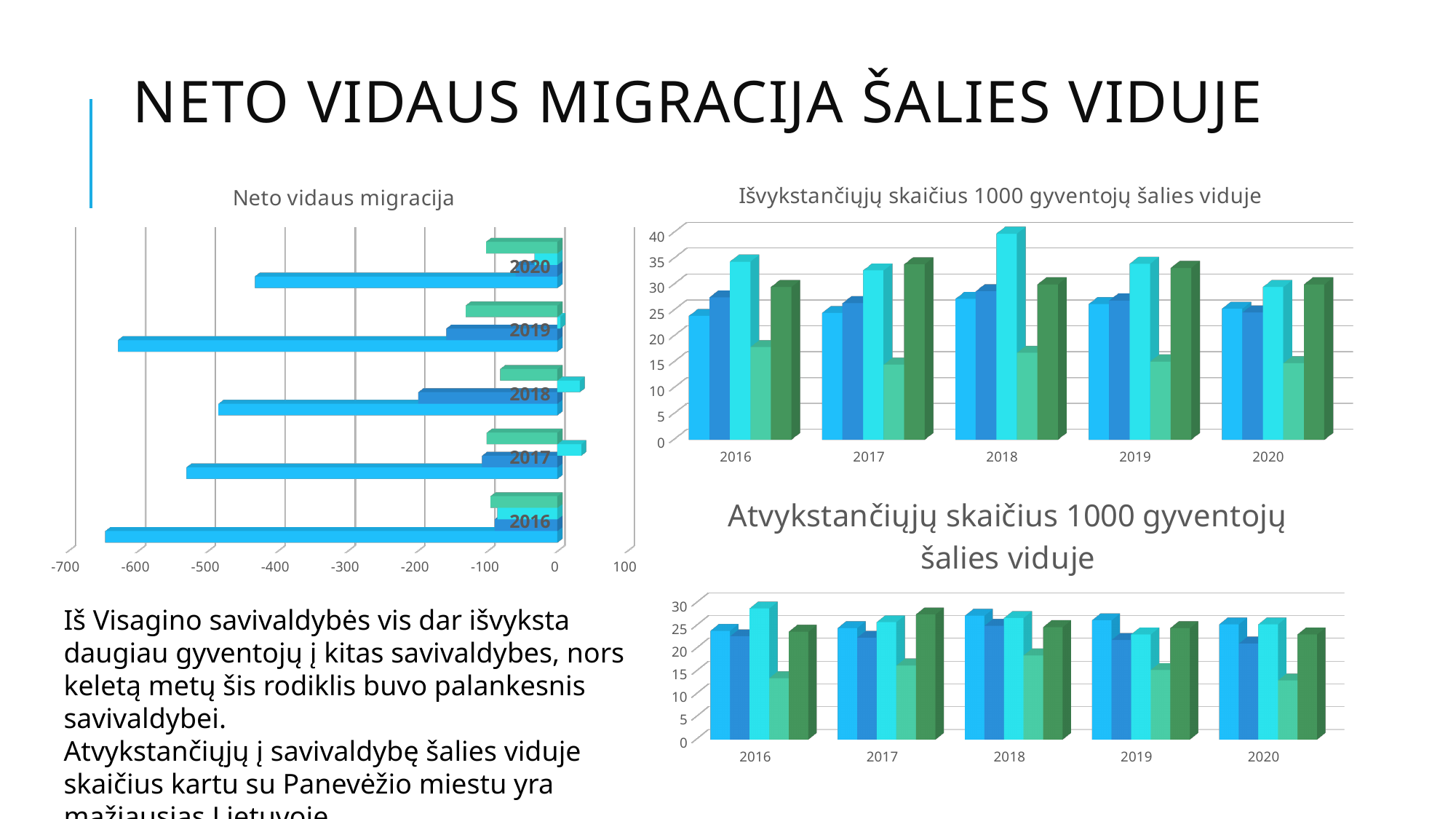
On the 'Neto vidaus migracija' chart, what is the lowest value shown on the horizontal axis? -700 How many years are shown on the 'Neto vidaus migracija' chart? 5 On the 'Atvykstančiųjų skaičius 1000 gyventojų šalies viduje' chart, what is the highest value shown on the vertical axis? 30 What kind of chart is the 'Neto vidaus migracija' chart? bar chart On the 'Atvykstančiųjų skaičius 1000 gyventojų šalies viduje' chart, is the light green bar for 2020 greater or less than 20? less How many years are shown on the 'Išvykstančiųjų skaičius 1000 gyventojų šalies viduje' chart? 5 On the 'Išvykstančiųjų skaičius 1000 gyventojų šalies viduje' chart, which year contains the tallest bar? 2018 On the 'Neto vidaus migracija' chart, is the value of the longest bar for 2016 greater or less than -600? less On the 'Neto vidaus migracija' chart, is the value of the longest bar for 2020 greater or less than -500? greater On the 'Išvykstančiųjų skaičius 1000 gyventojų šalies viduje' chart, how many bars are shown for each year? 5 What kind of chart is the 'Atvykstančiųjų skaičius 1000 gyventojų šalies viduje' chart? bar chart